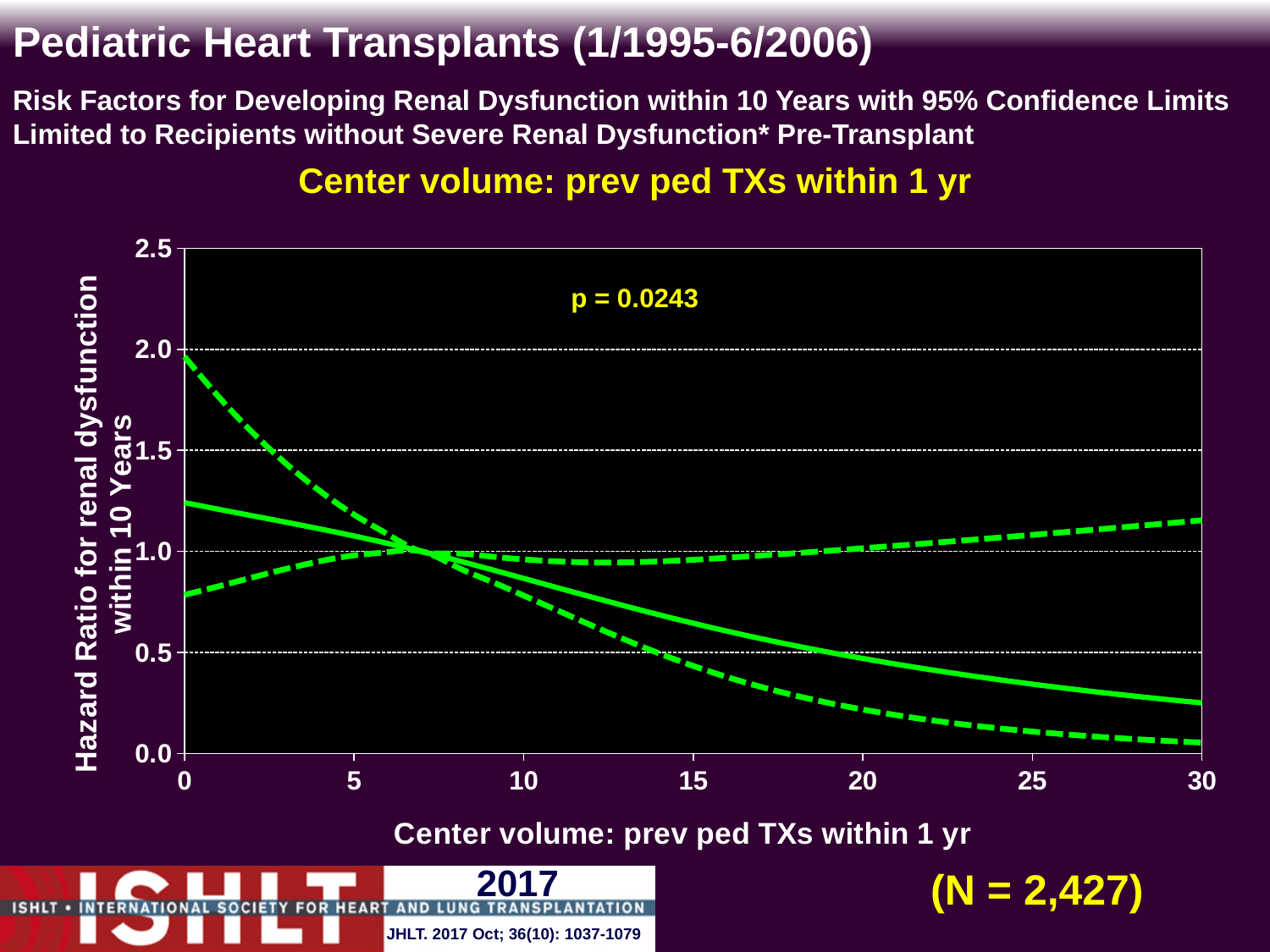
Is the solid hazard ratio line at a center volume of 15 greater or less than 1.0? less What kind of chart is shown on the slide? line chart What is the sample size (N) shown on the slide? N = 2,427 Is the solid hazard ratio line at a center volume of 0 greater or less than 1.0? greater What p-value is printed on the chart? p = 0.0243 Does the solid hazard ratio line rise or fall as center volume increases from 0 to 30? fall How many lines are plotted on the chart? 3 What is the label of the x axis? Center volume: prev ped TXs within 1 yr Is the solid hazard ratio line at a center volume of 30 greater or less than 0.5? less Is the solid hazard ratio line higher at a center volume of 0 or at a center volume of 30? 0